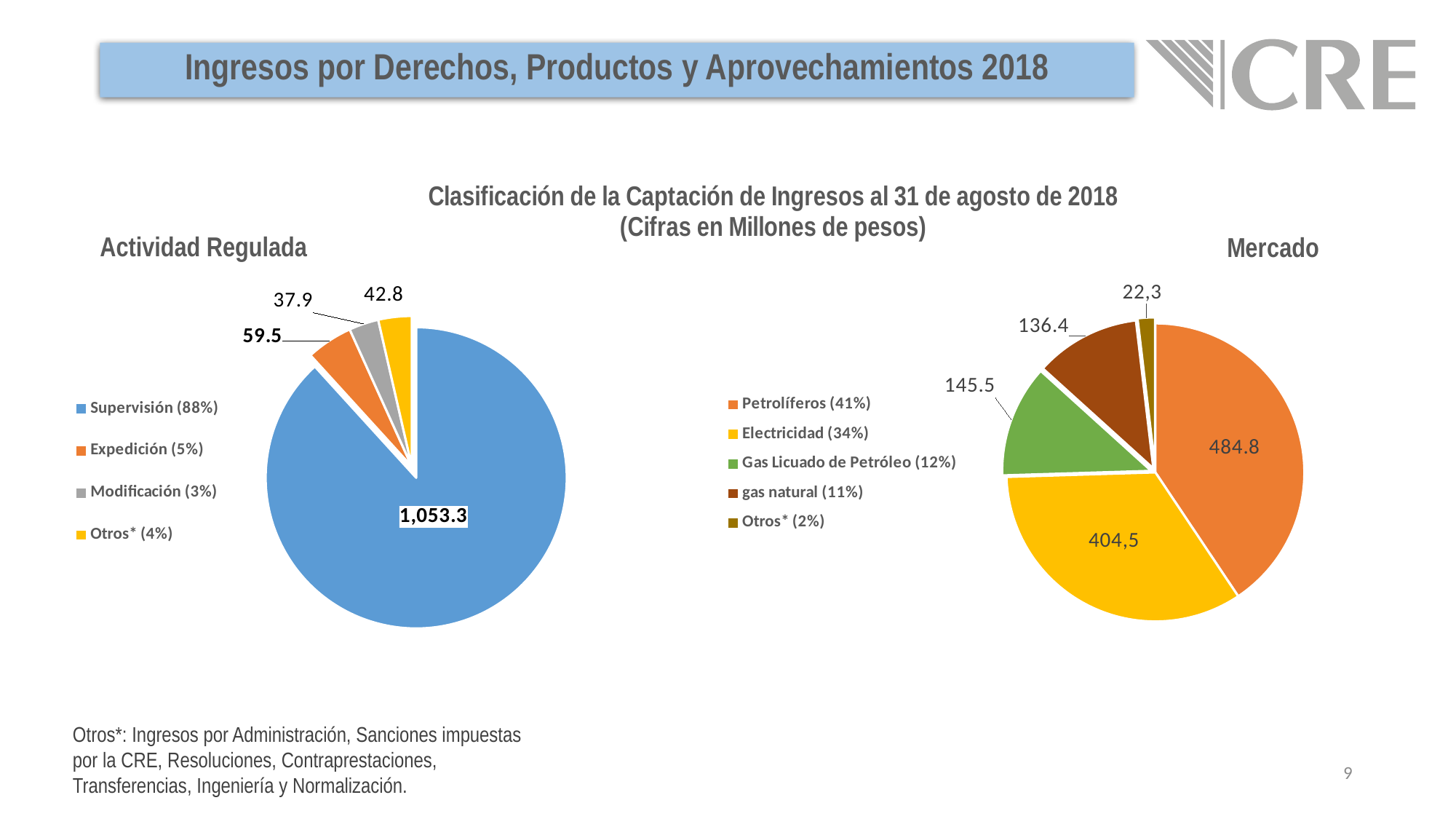
In the Actividad Regulada chart, what is the difference between Expedición and Otros*? 16.7 In the Mercado chart, what is the value for gas natural? 136.4 In the Actividad Regulada chart, what is the value for Supervisión? 1,053.3 In the Mercado chart, which category has the highest value? Petrolíferos In the Mercado chart, what is the value for Electricidad? 404,5 In the Mercado chart, what is the difference between Petrolíferos and Gas Licuado de Petróleo? 339.3 What type of chart is the Actividad Regulada chart? Pie chart How many categories does the Mercado chart show? 5 In the Mercado chart, which is larger, Gas Licuado de Petróleo or gas natural? Gas Licuado de Petróleo In the Actividad Regulada chart, which category has the lowest value? Modificación In the Actividad Regulada chart, what is the value for Expedición? 59.5 In the Mercado chart, what share of the pie does Electricidad represent? 34%